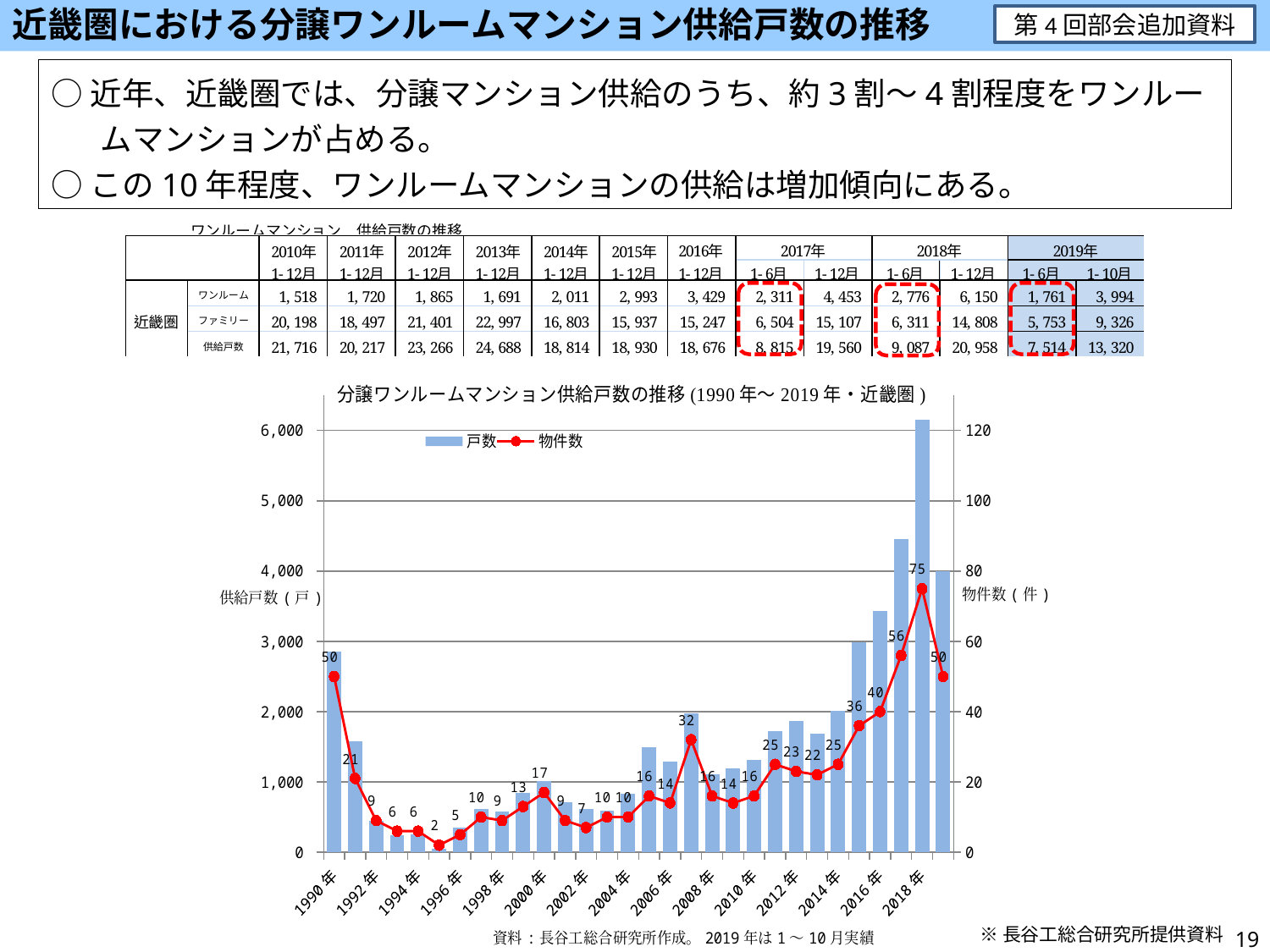
What is the 物件数 value for 1990年? 50 What is the 物件数 value for 2018年? 75 What kind of chart is shown on the slide? A combined bar and line chart What is the 物件数 value for 2000年? 17 Is the 戸数 bar for 2018年 greater or less than 6,000? greater What is the lowest 物件数 value labelled on the line? 2 What is the 物件数 value for 2016年? 40 Which year has the larger 物件数 value, 2012年 or 2014年? 2014年 In which year is the 物件数 line at its highest? 2018年 What is the difference between the 物件数 values for 2018年 and 2016年? 35 What are the two series named in the chart legend? 戸数 and 物件数 How many series does the chart legend list? 2